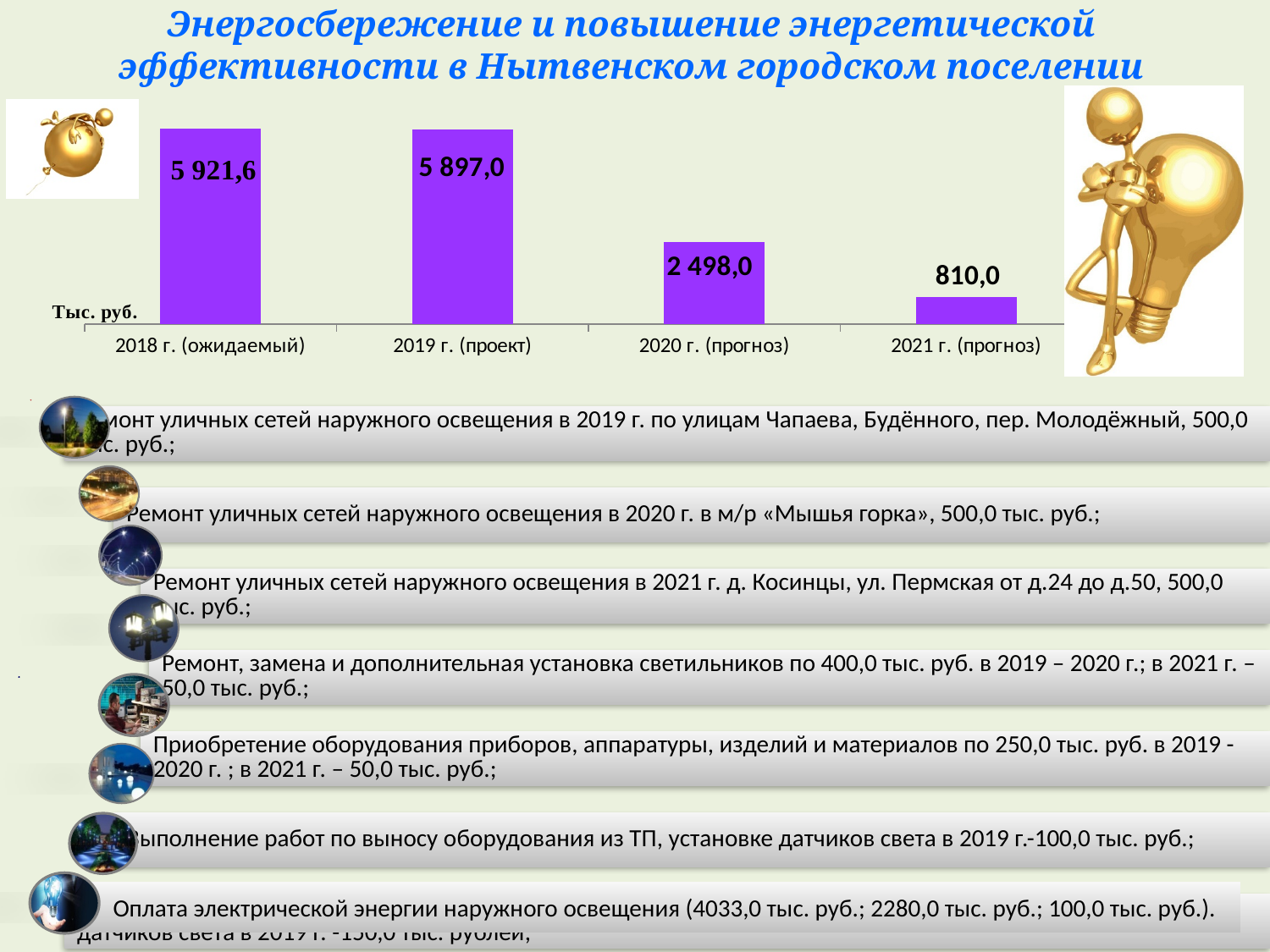
Which category has the highest value? 2018 г. (ожидаемый) Do the values rise or fall from 2018 г. (ожидаемый) to 2021 г. (прогноз)? fall Which is larger, the value for 2020 г. (прогноз) or the value for 2021 г. (прогноз)? 2020 г. (прогноз) What is the difference between the values for 2020 г. (прогноз) and 2021 г. (прогноз)? 1 688,0 What kind of chart is shown on the slide? bar chart What is the value for 2020 г. (прогноз)? 2 498,0 How many categories are shown on the x axis of the chart? 4 What is the value for 2018 г. (ожидаемый)? 5 921,6 What is the value for 2021 г. (прогноз)? 810,0 What is the value for 2019 г. (проект)? 5 897,0 Which category has the lowest value? 2021 г. (прогноз) What is the difference between the values for 2019 г. (проект) and 2020 г. (прогноз)? 3 399,0